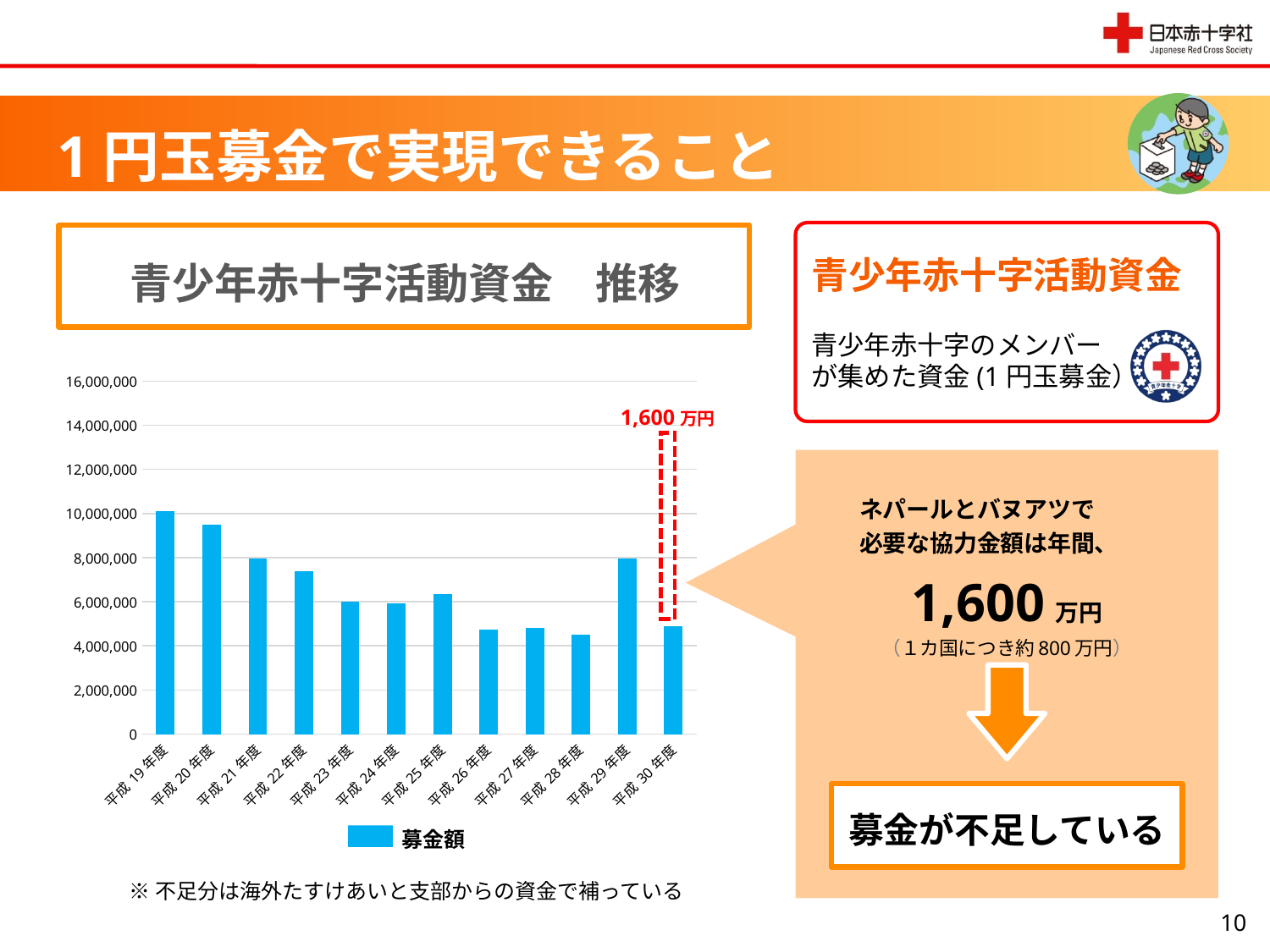
How many fiscal years (categories) are plotted on the x axis of the chart? 12 What kind of chart is shown on the slide? bar chart How many series does the chart legend list? 1 Is the value for 平成29年度 greater or less than 6,000,000? greater Is the value for 平成26年度 greater or less than 6,000,000? less Is the value for 平成30年度 greater or less than 6,000,000? less What is the legend entry for the series in the chart? 募金額 From 平成19年度 to 平成23年度, do the values rise or fall? fall Which fiscal year has the highest 募金額 in the chart? 平成19年度 What is the title shown above the chart? 青少年赤十字活動資金 推移 Which is larger, the value for 平成21年度 or the value for 平成26年度? 平成21年度